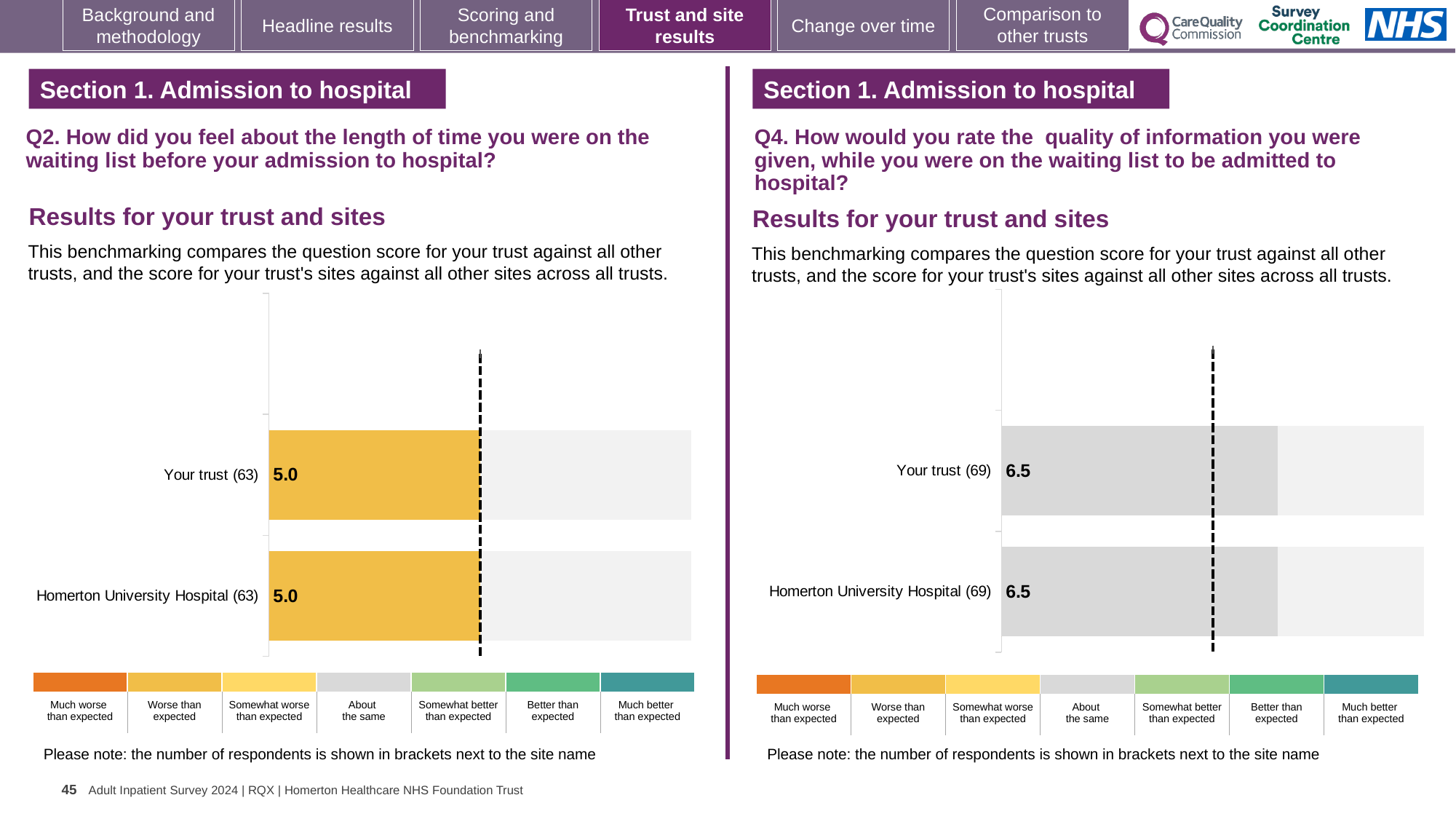
How many bars are plotted in the left chart (Q2)? 2 What kind of chart is used for the Q2 results on the left? Bar chart In the right chart (Q4), what is the score for Homerton University Hospital? 6.5 In the left chart (Q2), what is the score for Homerton University Hospital? 5.0 According to the colour key, which benchmark category do the bars in the right chart (Q4) fall into? About the same In the left chart (Q2), what is the score for Your trust? 5.0 In the left chart (Q2), how many respondents are shown in brackets next to Homerton University Hospital? 63 According to the colour key, which benchmark category do the bars in the left chart (Q2) fall into? Worse than expected In the left chart (Q2), what is the difference between the score for Your trust and the score for Homerton University Hospital? 0.0 In the right chart (Q4), how many respondents are shown in brackets next to Your trust? 69 How many bars are plotted in the right chart (Q4)? 2 In the right chart (Q4), what is the score for Your trust? 6.5